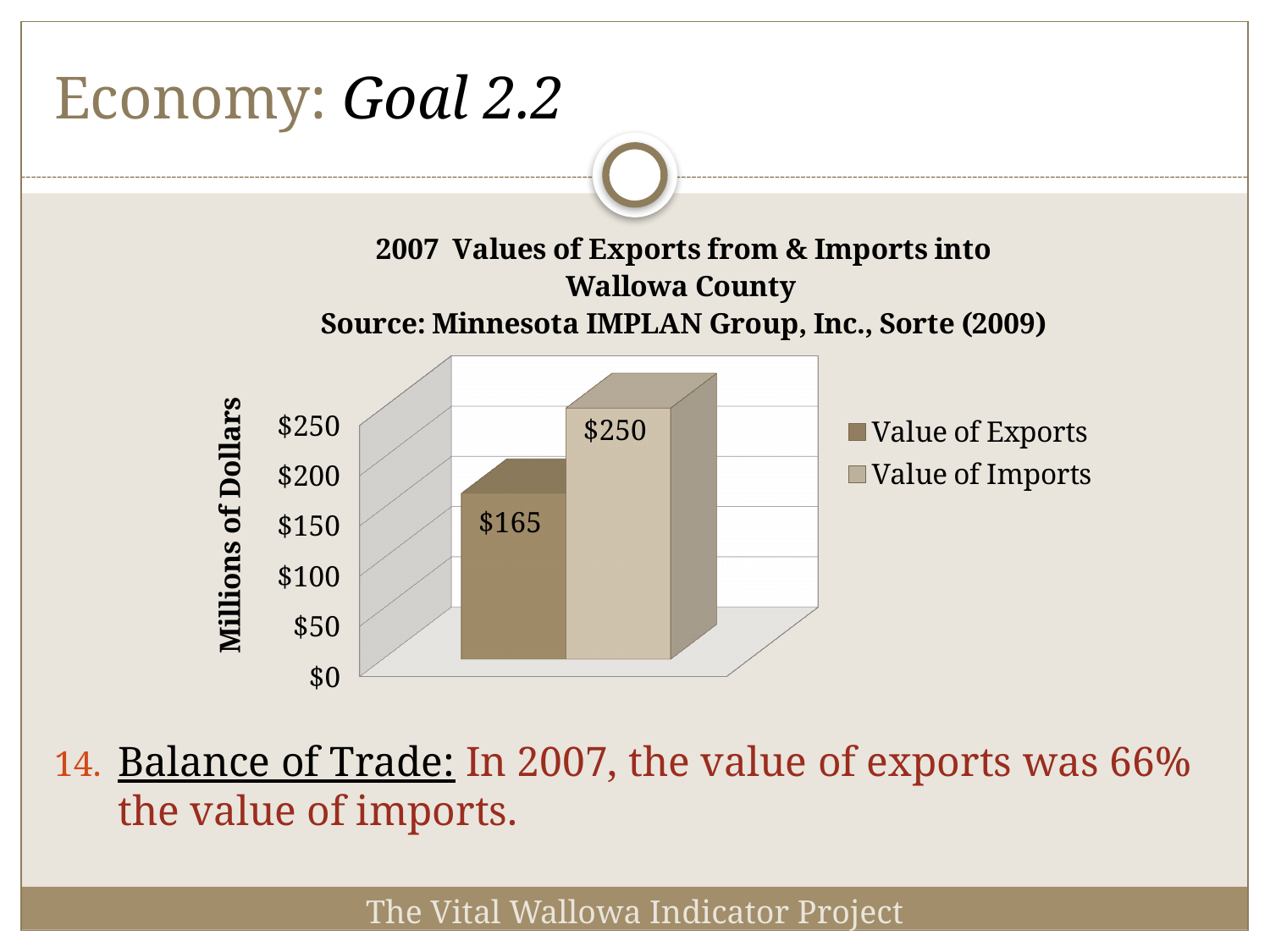
What is the difference between the value of imports and the value of exports? $85 Which series has the lower value on the chart? Value of Exports Is the value of exports greater or less than $200? less What is the value of imports shown on the chart? $250 Which series has the higher value, Value of Exports or Value of Imports? Value of Imports What source is cited in the chart title? Minnesota IMPLAN Group, Inc., Sorte (2009) What is the value of exports shown on the chart? $165 How many series does the legend list? 2 What kind of chart is shown on the slide? bar chart Is the value of exports larger or smaller than the value of imports? smaller What is the label on the vertical axis of the chart? Millions of Dollars What is the highest value shown on the vertical axis? $250